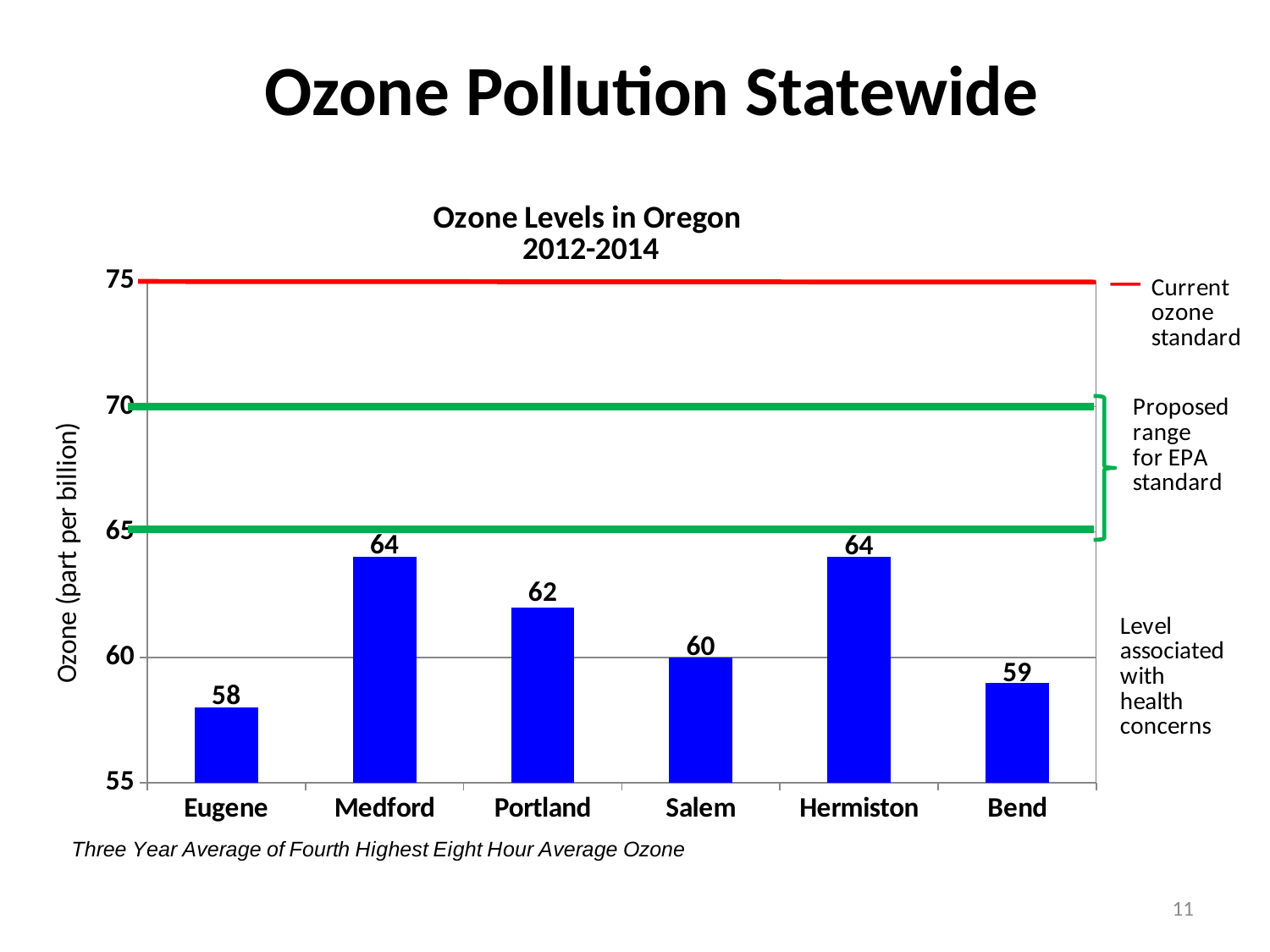
What is the ozone level for Medford? 64 What is the difference between the ozone levels of Portland and Salem? 2 What is the ozone level for Salem? 60 What is the title of the chart? Ozone Levels in Oregon 2012-2014 Which city has the lowest ozone level? Eugene What does the red line on the chart represent? Current ozone standard Is the value for Hermiston greater or less than 65? less What is the ozone level for Bend? 59 What is the difference between the ozone levels of Medford and Eugene? 6 Which has a higher ozone level, Portland or Bend? Portland How many cities are shown in the chart? 6 What kind of chart is shown on the slide? bar chart